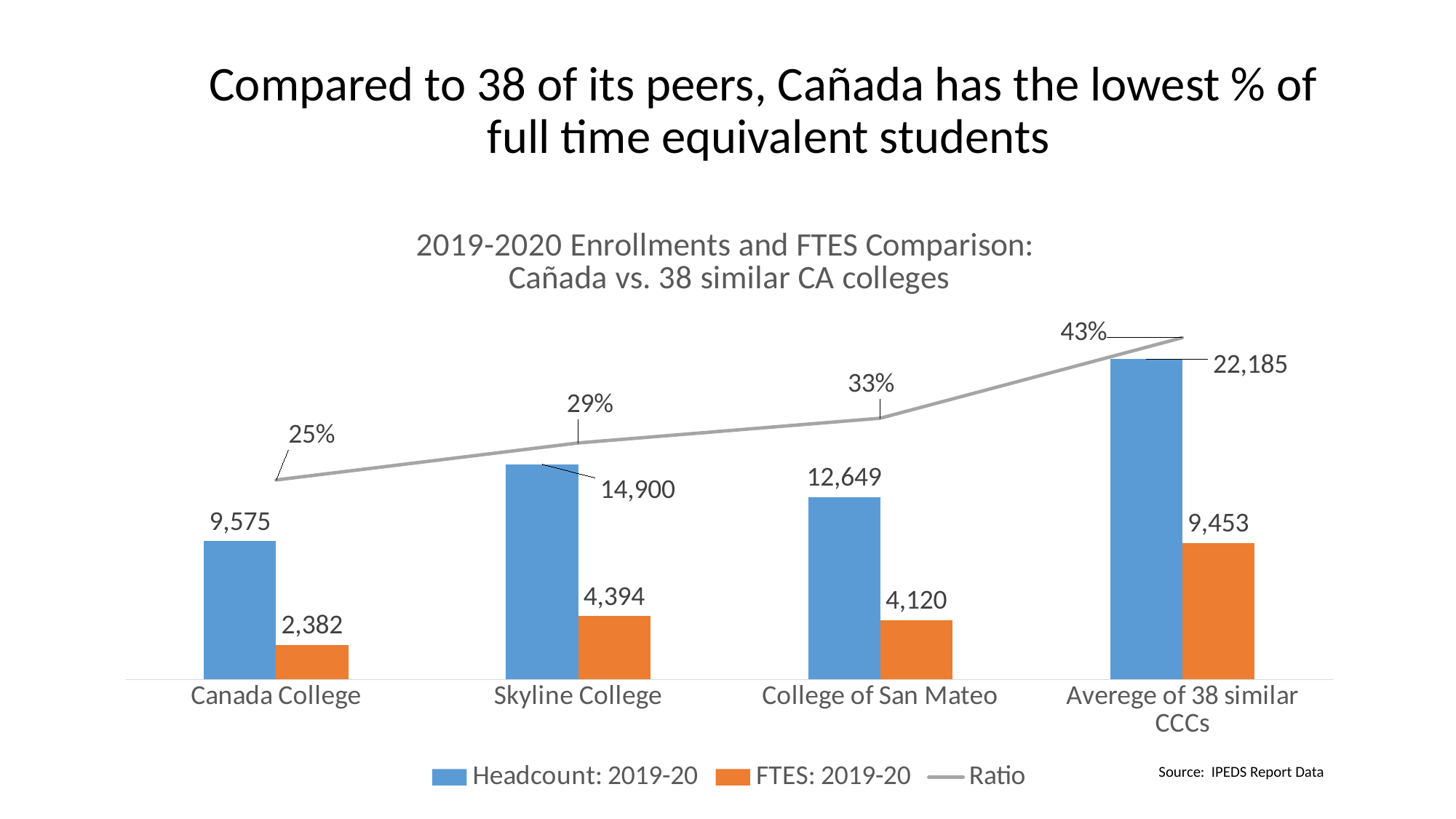
How many series does the legend list? 3 What is the Ratio value for Canada College? 25% What is the title of the chart? 2019-2020 Enrollments and FTES Comparison: Cañada vs. 38 similar CA colleges What is the Headcount: 2019-20 value for Skyline College? 14,900 What is the difference between the Headcount: 2019-20 values for Skyline College and Canada College? 5,325 Which category has the lowest Ratio value? Canada College Which category has the highest FTES: 2019-20 value? Averege of 38 similar CCCs Which is larger, the FTES: 2019-20 value for Skyline College or for College of San Mateo? Skyline College Does the Ratio line rise or fall from left to right across the categories? rises What is the Headcount: 2019-20 value for the Averege of 38 similar CCCs? 22,185 What is the FTES: 2019-20 value for College of San Mateo? 4,120 How many categories are shown on the x axis? 4